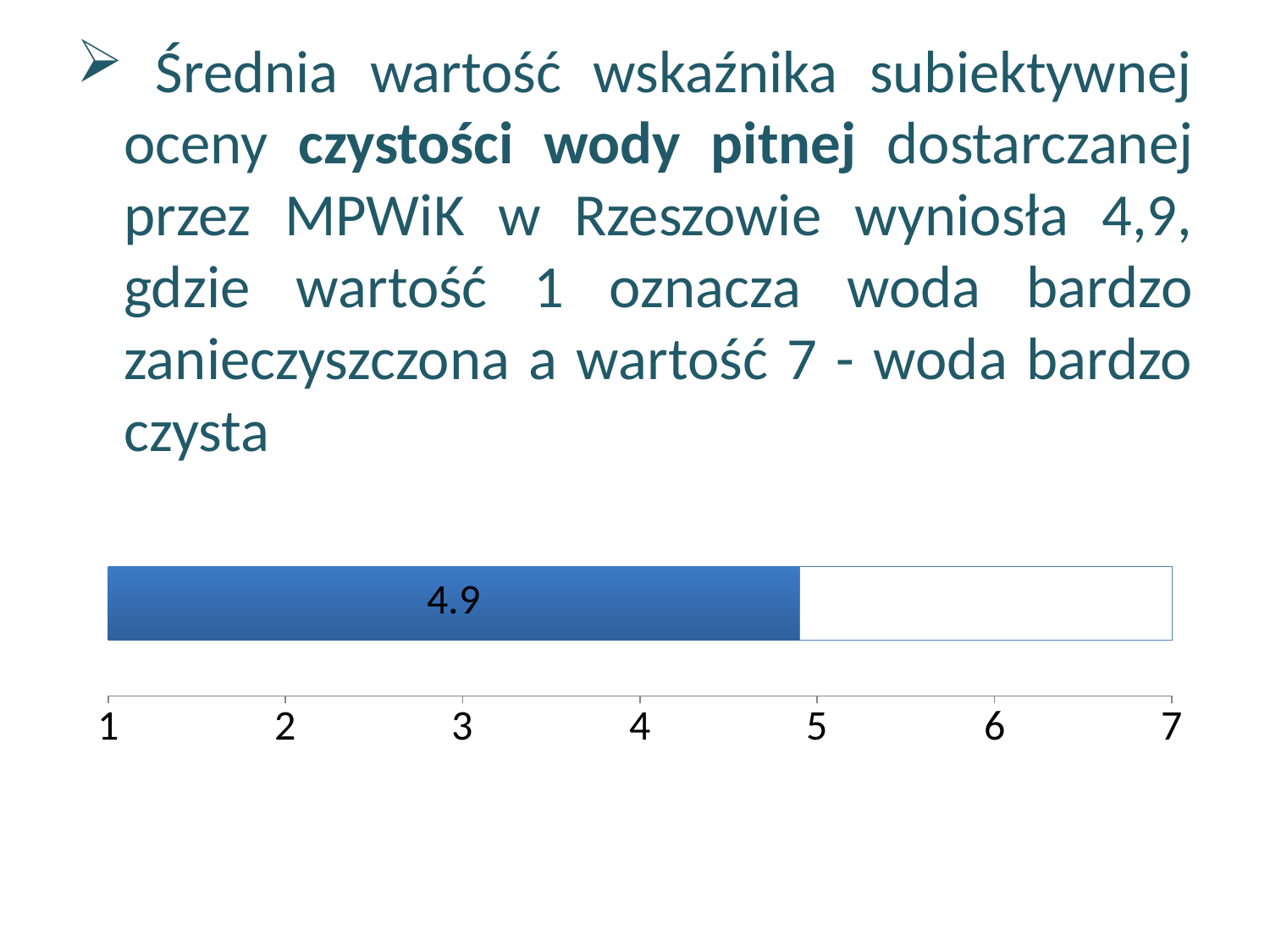
How many tick labels are shown on the chart's axis? 7 What is the lowest tick value shown on the chart's axis? 1 Is the value of the bar greater or less than 5? less Is the value of the bar greater or less than 4? greater What kind of chart is shown on the slide? bar chart What is the highest tick value shown on the chart's axis? 7 Is the value of the bar greater or less than 3? greater What value is printed on the bar in the chart? 4.9